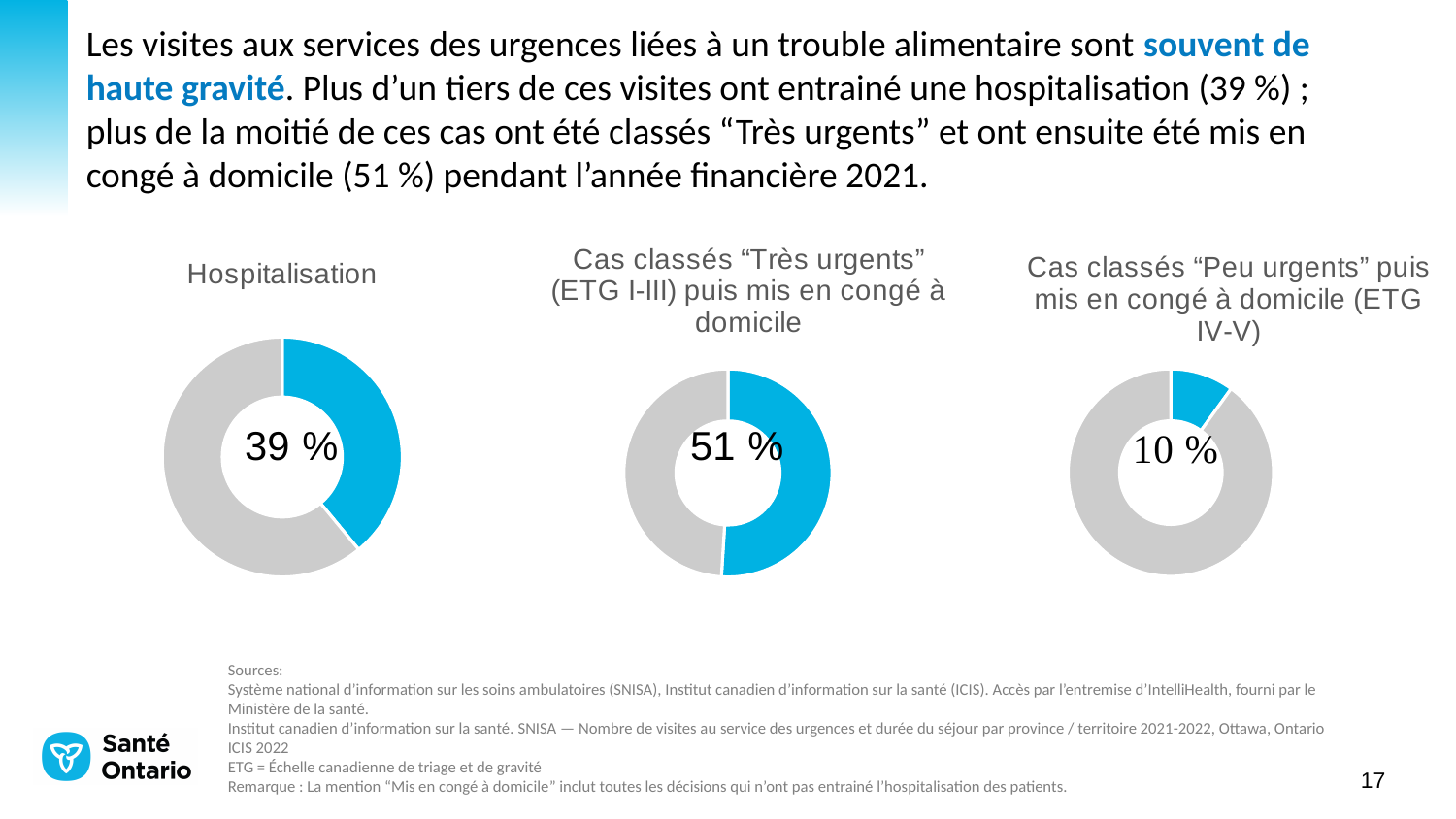
Across the three donut charts, which chart shows the highest percentage? Cas classés “Très urgents” (ETG I-III) puis mis en congé à domicile In the "Peu urgents" chart, what colour is the slice representing 10 %? Blue What type of chart is used for "Hospitalisation"? Donut (pie) chart Across the three donut charts, which chart shows the lowest percentage? Cas classés “Peu urgents” puis mis en congé à domicile (ETG IV-V) In the chart titled "Cas classés “Très urgents” (ETG I-III) puis mis en congé à domicile", what value is printed? 51 % In the "Hospitalisation" chart, what percentage is shown in the centre of the donut? 39 % What is the difference between the percentage in the "Hospitalisation" chart and the percentage in the "Peu urgents" chart? 29 % How many donut charts are shown on the slide? 3 In the "Hospitalisation" chart, what share of the donut is coloured blue? 39 % In the chart titled "Cas classés “Peu urgents” puis mis en congé à domicile (ETG IV-V)", what value is printed? 10 % Which is larger: the percentage in the "Hospitalisation" chart or the percentage in the "Peu urgents" chart? Hospitalisation What is the difference between the percentage in the "Très urgents" chart and the percentage in the "Hospitalisation" chart? 12 %